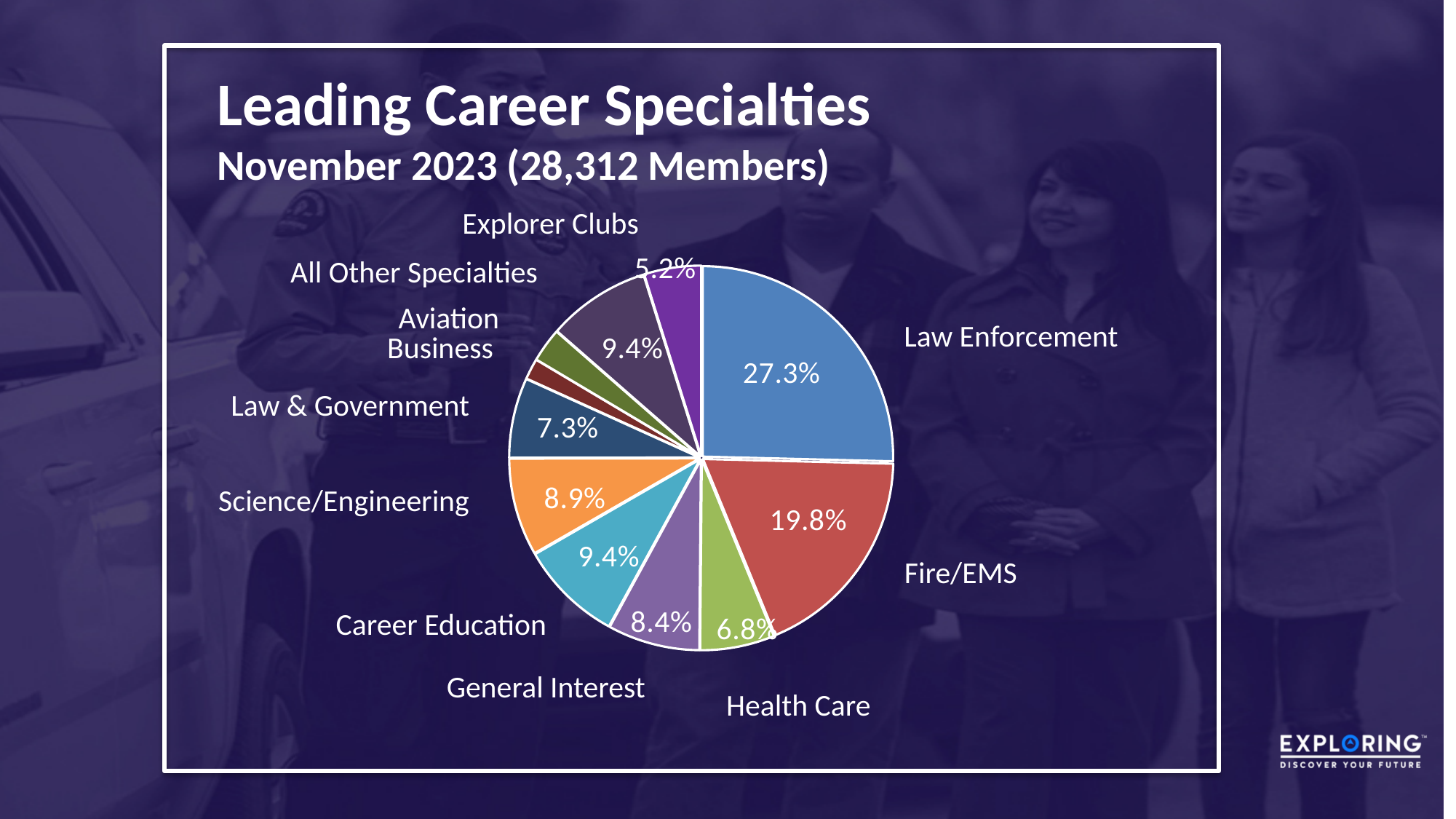
How many members does the subtitle say the data covers? 28,312 What is the value for Health Care? 6.8% What percentage is shown for Science/Engineering? 8.9% What percentage is shown for Fire/EMS? 19.8% What share of members does Law Enforcement account for? 27.3% Which career specialty has the largest share of the pie? Law Enforcement What is the difference in percentage points between Law Enforcement and Fire/EMS? 7.5 What share does Explorer Clubs represent? 5.2% Which is larger, the share for Career Education or the share for General Interest? Career Education What type of chart is shown on the slide? Pie chart How many career specialty categories are shown in the pie chart? 11 Which is larger, Law & Government or Health Care? Law & Government